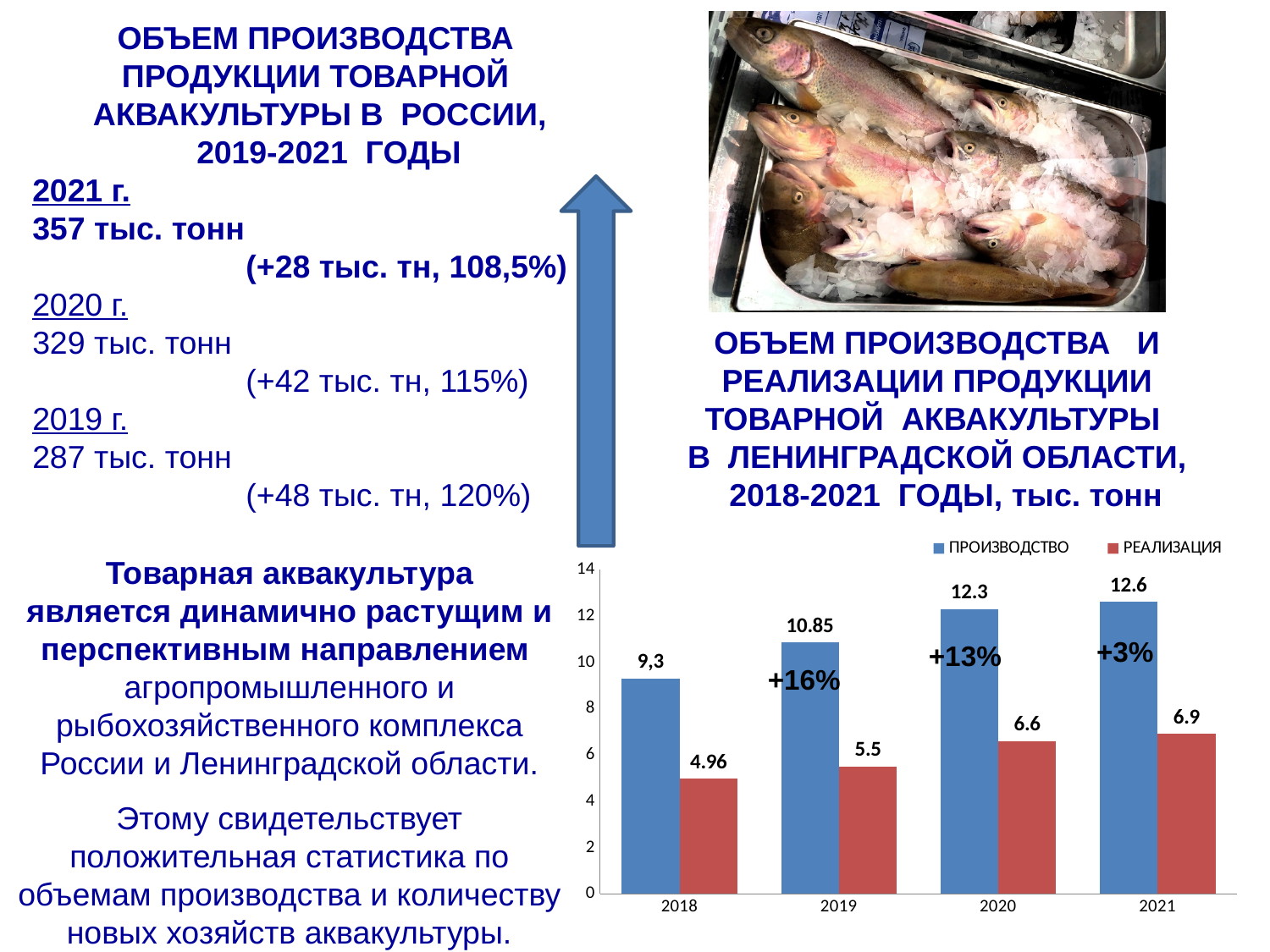
What is the value of ПРОИЗВОДСТВО for 2018? 9,3 What is the value of РЕАЛИЗАЦИЯ for 2019? 5.5 What percentage growth label is shown above the 2019 bars? +16% In which year is ПРОИЗВОДСТВО highest? 2021 What is the value of ПРОИЗВОДСТВО for 2020? 12.3 What is the value of РЕАЛИЗАЦИЯ for 2021? 6.9 How many series does the chart legend list? 2 Does ПРОИЗВОДСТВО rise or fall from 2018 to 2021? rise How many years are shown on the x axis of the chart? 4 What kind of chart is shown on the slide? bar chart What is the difference between ПРОИЗВОДСТВО and РЕАЛИЗАЦИЯ in 2020? 5.7 In which year is РЕАЛИЗАЦИЯ lowest? 2018